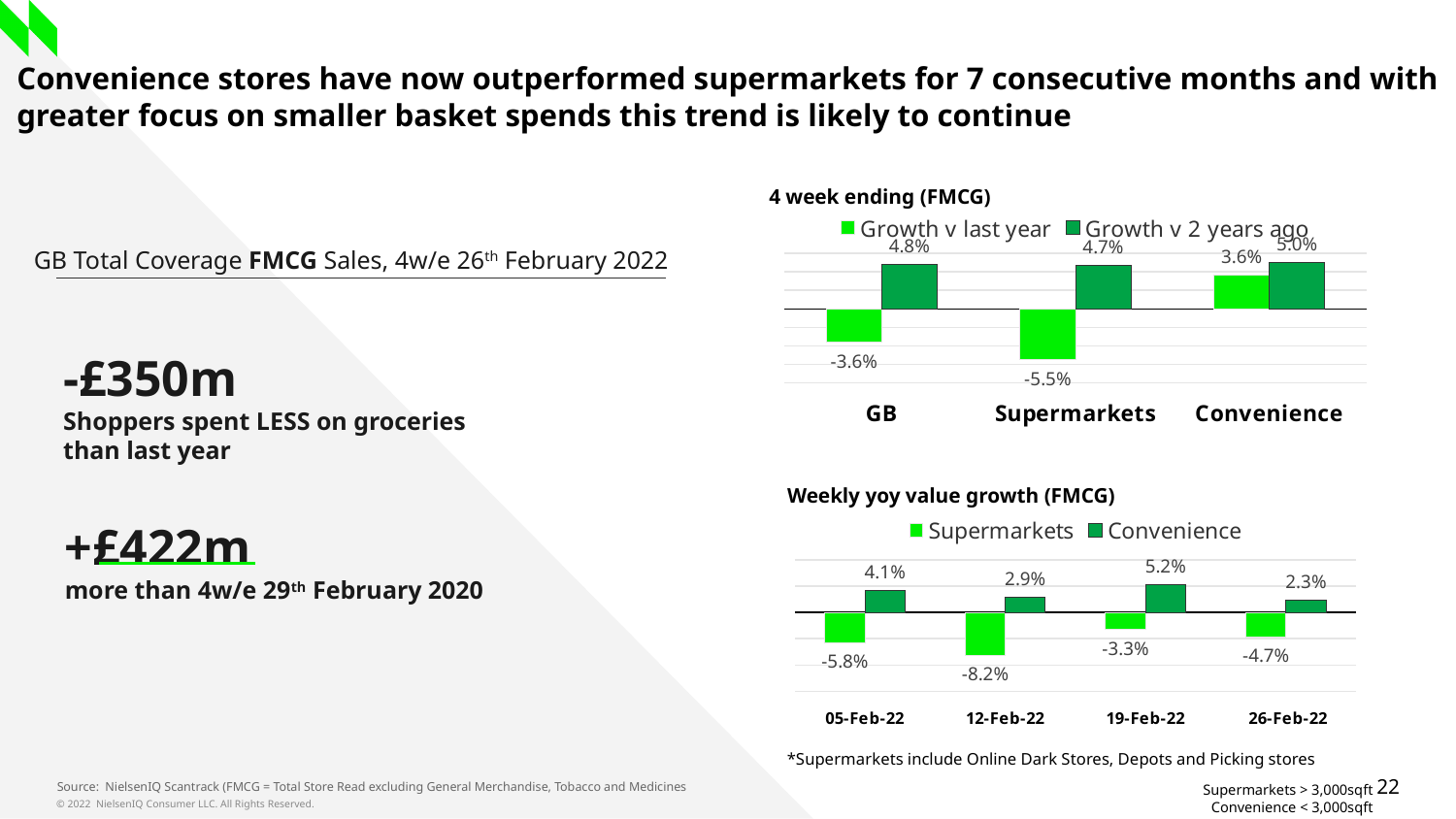
In the '4 week ending (FMCG)' chart, what is the difference between the Growth v 2 years ago values for GB and Supermarkets? 0.1% What kind of chart is the 'Weekly yoy value growth (FMCG)' chart? Bar chart In the '4 week ending (FMCG)' chart, which category has the highest Growth v last year value? Convenience In the 'Weekly yoy value growth (FMCG)' chart, what is the Supermarkets value for 12-Feb-22? -8.2% In the 'Weekly yoy value growth (FMCG)' chart, which week has the lowest Supermarkets value? 12-Feb-22 In the 'Weekly yoy value growth (FMCG)' chart, what is the Convenience value for 19-Feb-22? 5.2% In the '4 week ending (FMCG)' chart, what is the Growth v last year value for Supermarkets? -5.5% In the '4 week ending (FMCG)' chart, which category has the lowest Growth v last year value? Supermarkets In the '4 week ending (FMCG)' chart, what is the Growth v 2 years ago value for Convenience? 5.0% How many series does the legend of the '4 week ending (FMCG)' chart list? 2 In the 'Weekly yoy value growth (FMCG)' chart, how many weeks are shown on the x axis? 4 In the 'Weekly yoy value growth (FMCG)' chart, which week has the highest Convenience value? 19-Feb-22